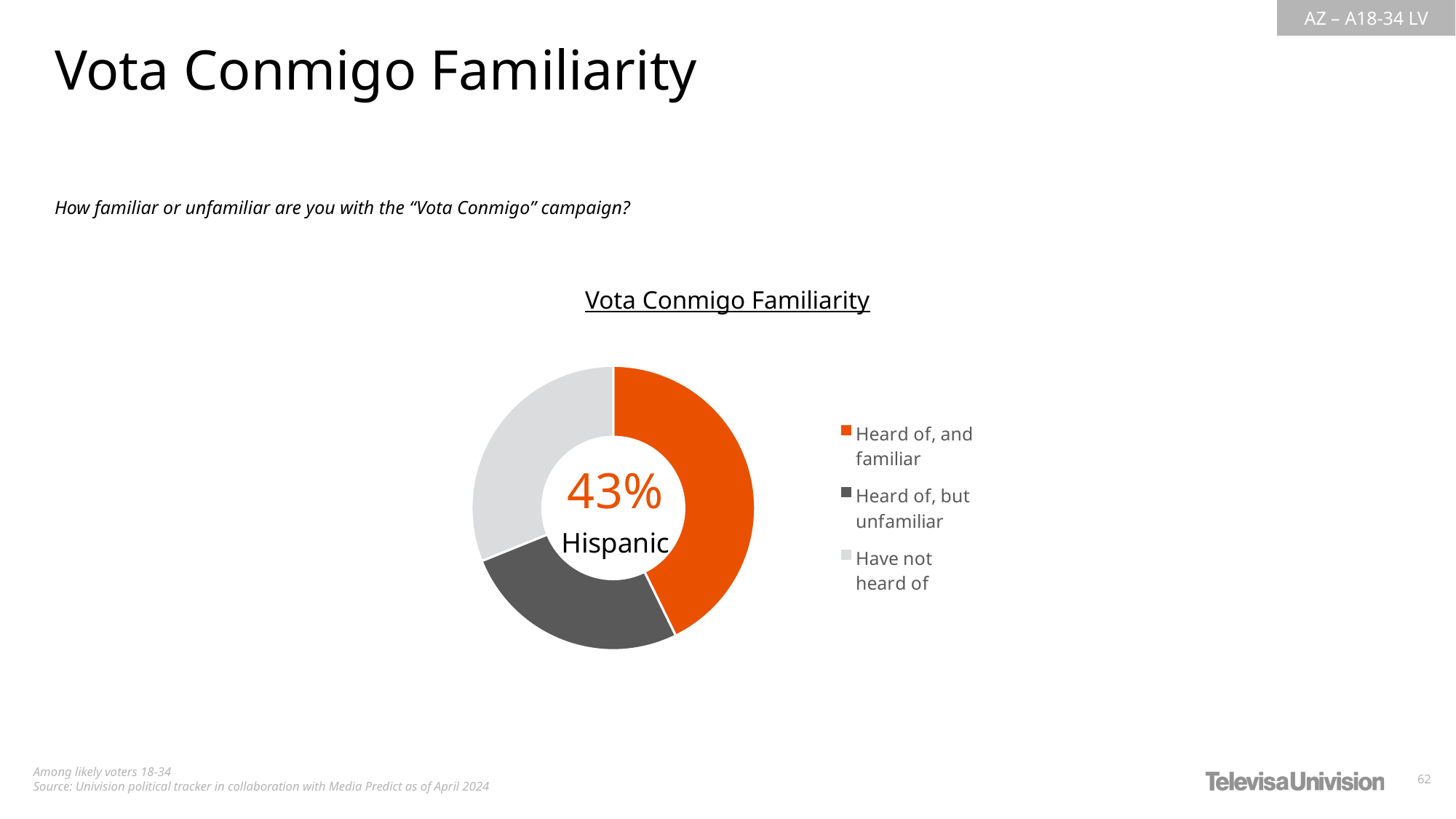
What kind of chart is shown on the slide? doughnut chart Which is larger: the slice for Heard of, and familiar or the slice for Have not heard of? Heard of, and familiar Which category is the largest slice of the Vota Conmigo Familiarity chart? Heard of, and familiar What group label is printed in the center of the donut chart? Hispanic How many entries does the legend of the chart list? 3 How many categories does the Vota Conmigo Familiarity chart show? 3 What share of the pie does the Heard of, and familiar slice represent? 43% Which is larger: the slice for Heard of, and familiar or the slice for Heard of, but unfamiliar? Heard of, and familiar What percentage of Hispanic likely voters have heard of, and are familiar with, the Vota Conmigo campaign? 43% What is the title of the chart? Vota Conmigo Familiarity